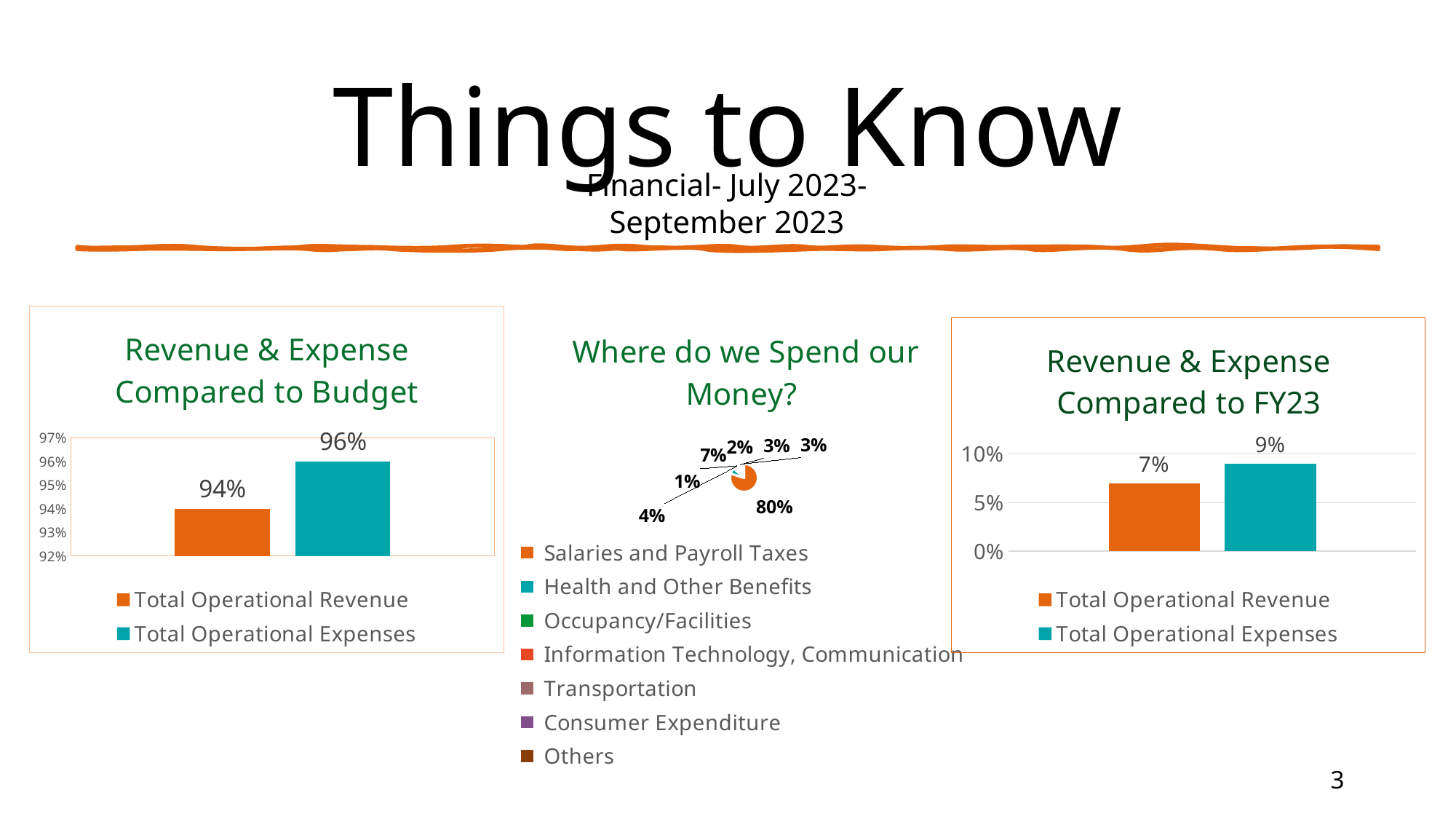
How many categories does the legend of the 'Where do we Spend our Money?' chart list? 7 How many series does the legend of the 'Revenue & Expense Compared to FY23' chart list? 2 In the 'Where do we Spend our Money?' chart, what share of spending goes to Salaries and Payroll Taxes? 80% In the 'Revenue & Expense Compared to Budget' chart, which series has the higher value? Total Operational Expenses In the 'Revenue & Expense Compared to FY23' chart, what is the value for Total Operational Expenses? 9% In the 'Revenue & Expense Compared to Budget' chart, what is the value for Total Operational Revenue? 94% What kind of chart is 'Revenue & Expense Compared to Budget'? Bar chart In the 'Revenue & Expense Compared to Budget' chart, what is the value for Total Operational Expenses? 96% In the 'Revenue & Expense Compared to Budget' chart, what is the difference between Total Operational Expenses and Total Operational Revenue? 2% In the 'Revenue & Expense Compared to FY23' chart, what is the value for Total Operational Revenue? 7% In the 'Revenue & Expense Compared to FY23' chart, is the value for Total Operational Revenue greater or less than 5%? greater In the 'Revenue & Expense Compared to FY23' chart, what is the difference between Total Operational Expenses and Total Operational Revenue? 2%